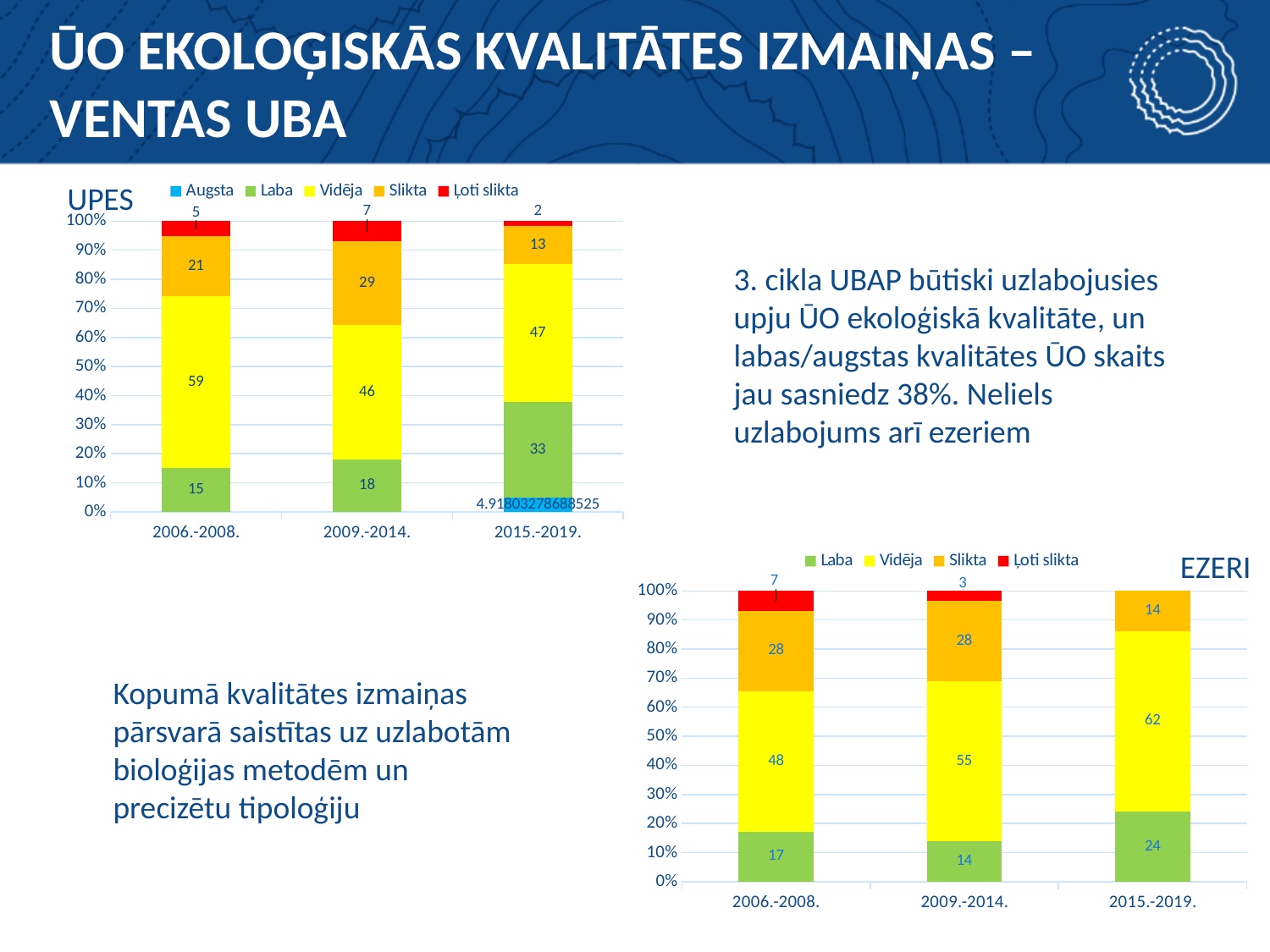
What kind of chart is the EZERI chart? Stacked bar chart In the UPES chart, how many series does the legend list? 5 In the UPES chart, what is the value for Slikta in 2009.-2014.? 29 In the EZERI chart, is the Vidēja value for 2006.-2008. or 2009.-2014. larger? 2009.-2014. In the UPES chart, what is the value for Vidēja in 2006.-2008.? 59 In the EZERI chart, how many series does the legend list? 4 In the UPES chart, what is the value for Laba in 2015.-2019.? 33 In the UPES chart, what is the difference between the Slikta values for 2009.-2014. and 2015.-2019.? 16 In the EZERI chart, which period has the lowest value for Slikta? 2015.-2019. In the UPES chart, which period has the highest value for Laba? 2015.-2019. In the EZERI chart, what is the value for Laba in 2009.-2014.? 14 In the EZERI chart, what is the value for Vidēja in 2015.-2019.? 62